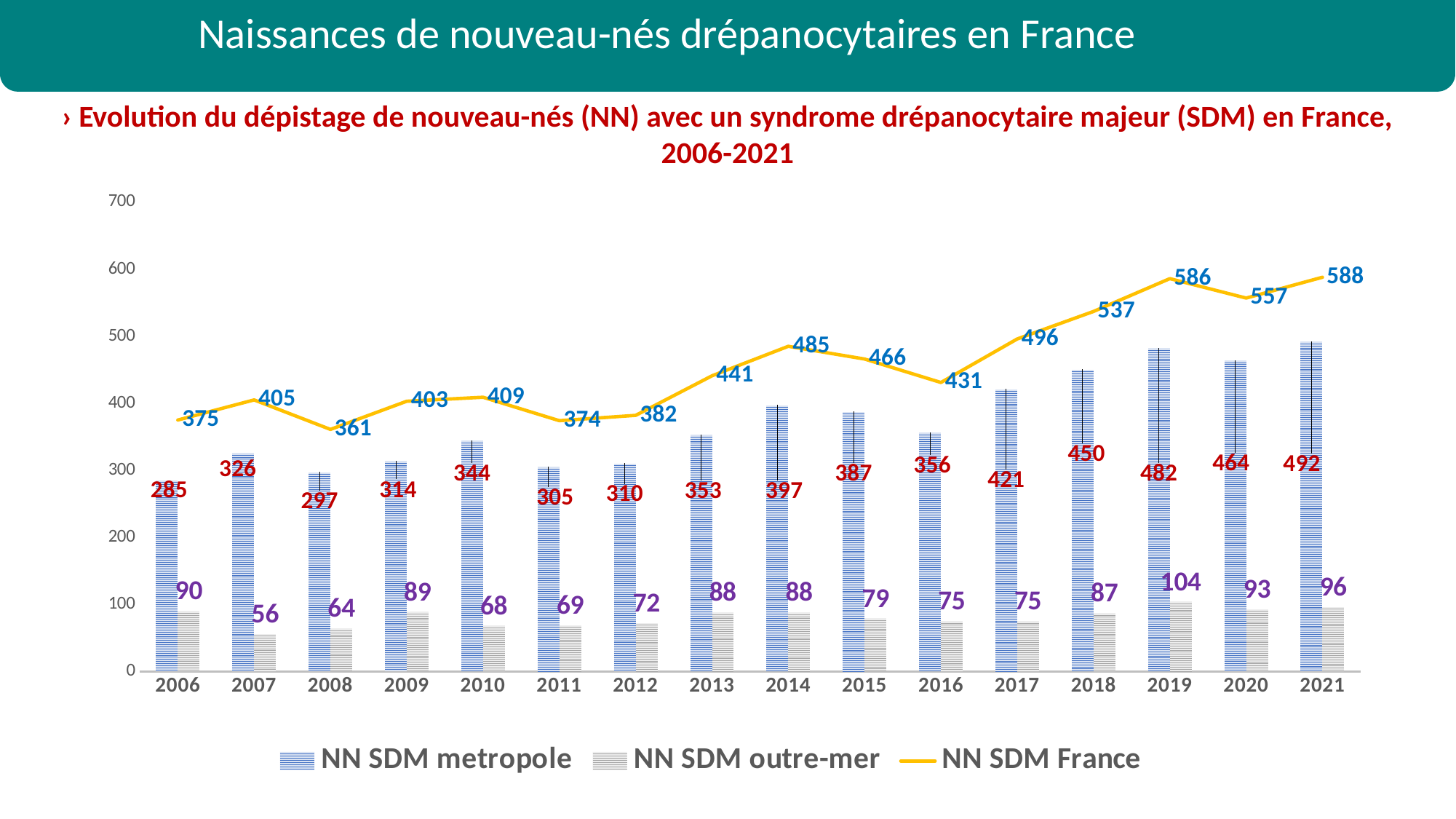
What kind of chart is this? Combined bar and line chart What is the value of NN SDM metropole in 2014? 397 Which year has the lowest value for NN SDM outre-mer? 2007 What is the value of NN SDM outre-mer in 2019? 104 Does NN SDM France generally rise or fall from 2006 to 2021? Rise What is the value of NN SDM France in 2016? 431 How many series does the legend list? 3 What is the difference between NN SDM France in 2021 and in 2006? 213 Which year has the highest value for NN SDM France? 2021 What colour is the NN SDM France line? Yellow How many years are shown on the x axis? 16 Which is larger, NN SDM metropole in 2019 or in 2020? 2019